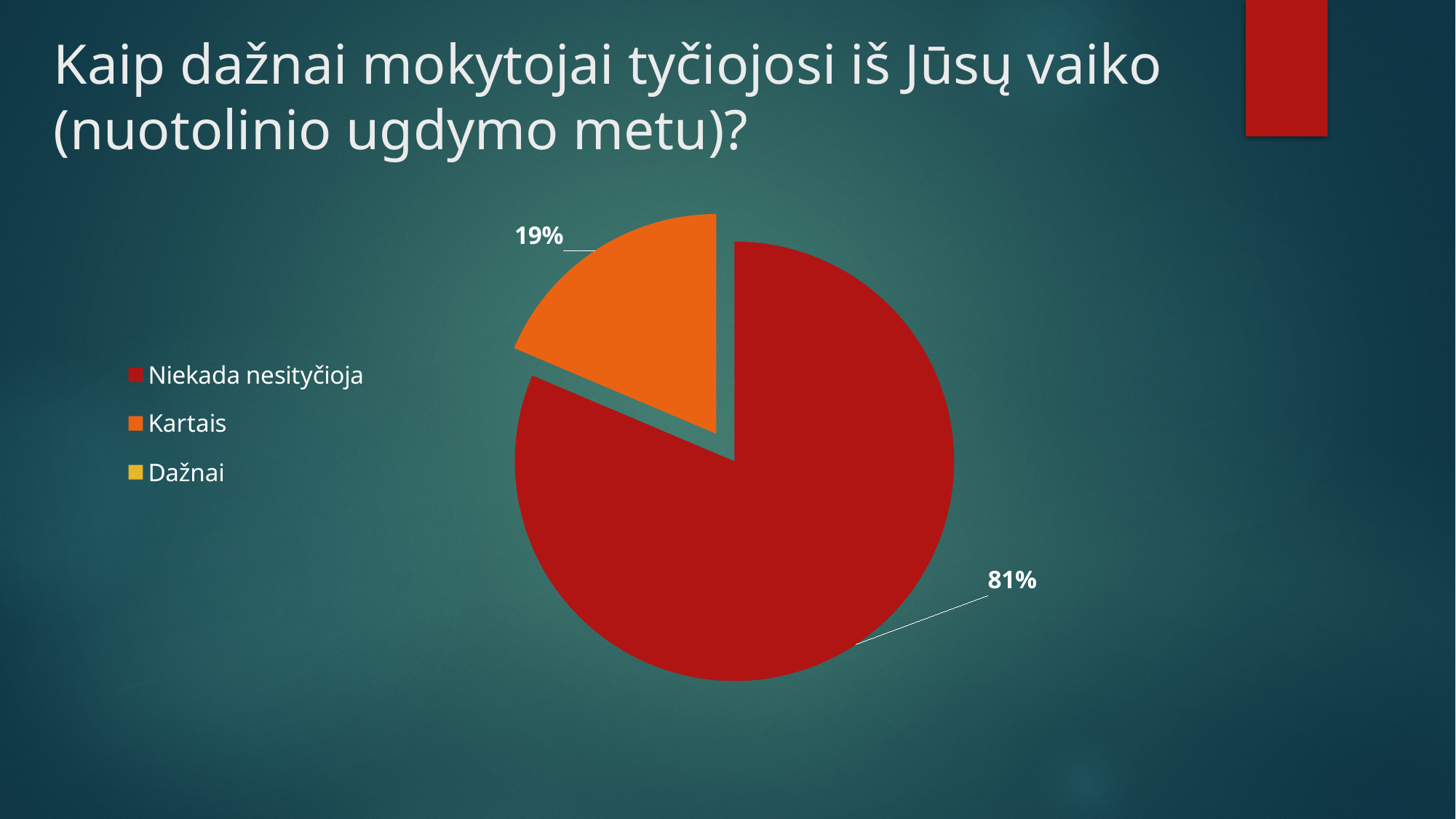
Which legend entry has no visible slice in the pie? Dažnai What share of the pie does "Niekada nesityčioja" represent? 81% Which category has the largest slice of the pie? Niekada nesityčioja Which of the two labelled slices is larger, "Kartais" or "Niekada nesityčioja"? Niekada nesityčioja What share of the pie does "Kartais" represent? 19% What is the difference in percentage points between the "Niekada nesityčioja" slice and the "Kartais" slice? 62 percentage points What kind of chart is shown on the slide? Pie chart Is the share for "Niekada nesityčioja" greater or less than 50%? greater How many categories does the legend list? 3 What colour is the "Kartais" slice? Orange